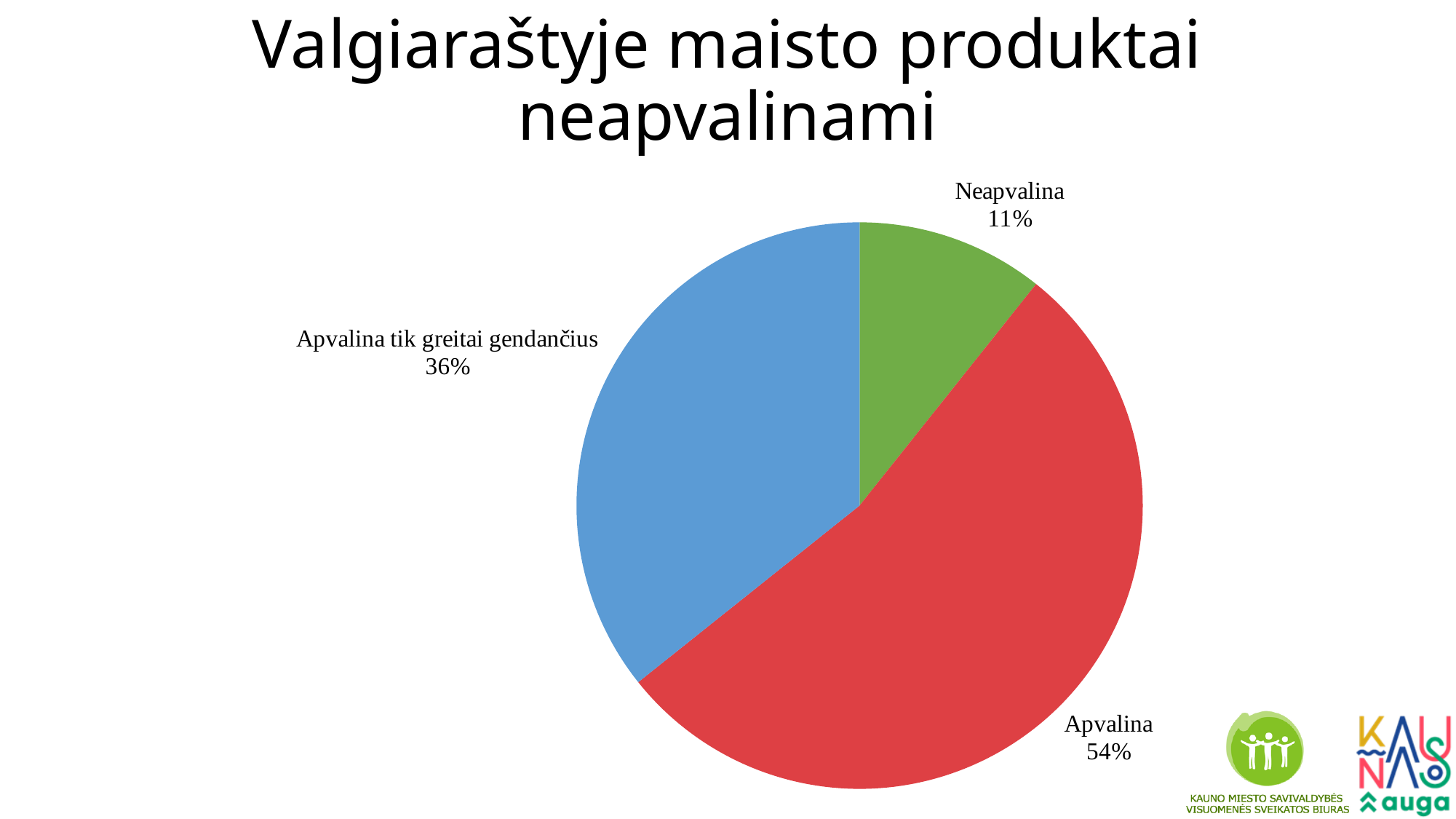
What is the difference in percentage points between the "Apvalina tik greitai gendančius" and "Neapvalina" slices? 25 What share of the pie does the "Apvalina tik greitai gendančius" slice represent? 36% What share of the pie does the "Apvalina" slice represent? 54% Which slice of the pie is the smallest? Neapvalina Which slice of the pie is the largest? Apvalina What share of the pie does the "Neapvalina" slice represent? 11% Which is larger, the "Neapvalina" slice or the "Apvalina tik greitai gendančius" slice? Apvalina tik greitai gendančius What colour is the "Apvalina" slice of the pie? red What is the difference in percentage points between the "Apvalina" and "Apvalina tik greitai gendančius" slices? 18 What is the title of the chart on the slide? Valgiaraštyje maisto produktai neapvalinami What kind of chart is shown on the slide? pie chart How many slices does the pie chart have? 3